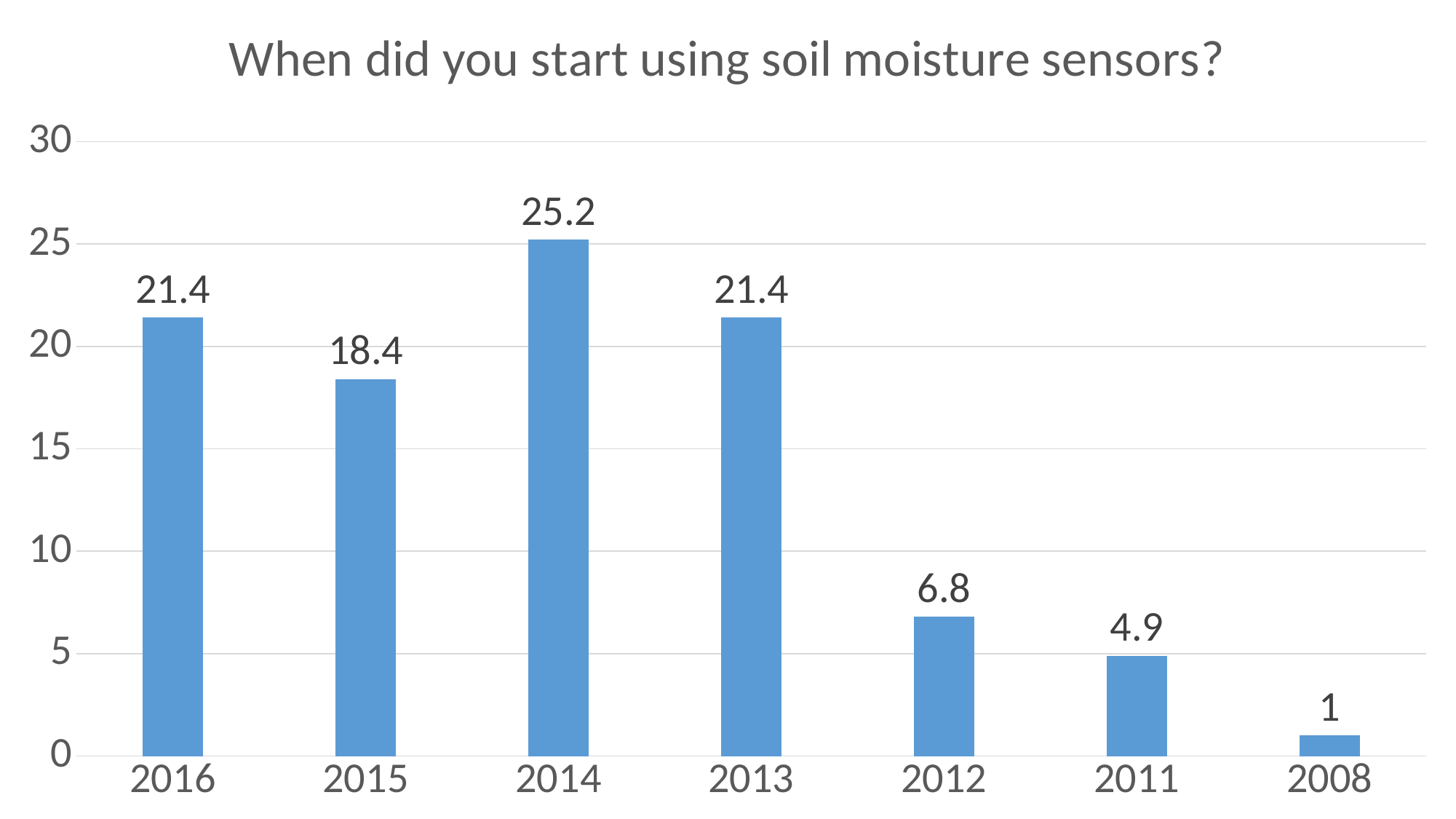
What is the value for 2008? 1 What is the difference between the values for 2012 and 2011? 1.9 What is the value for 2014? 25.2 Which is larger, the value for 2012 or the value for 2011? 2012 How many years are shown on the x axis? 7 Which year has the lowest value? 2008 What is the value for 2011? 4.9 What is the value for 2015? 18.4 Which year has the highest value? 2014 What kind of chart is this? bar chart What is the difference between the values for 2014 and 2015? 6.8 What is the title of the chart? When did you start using soil moisture sensors?